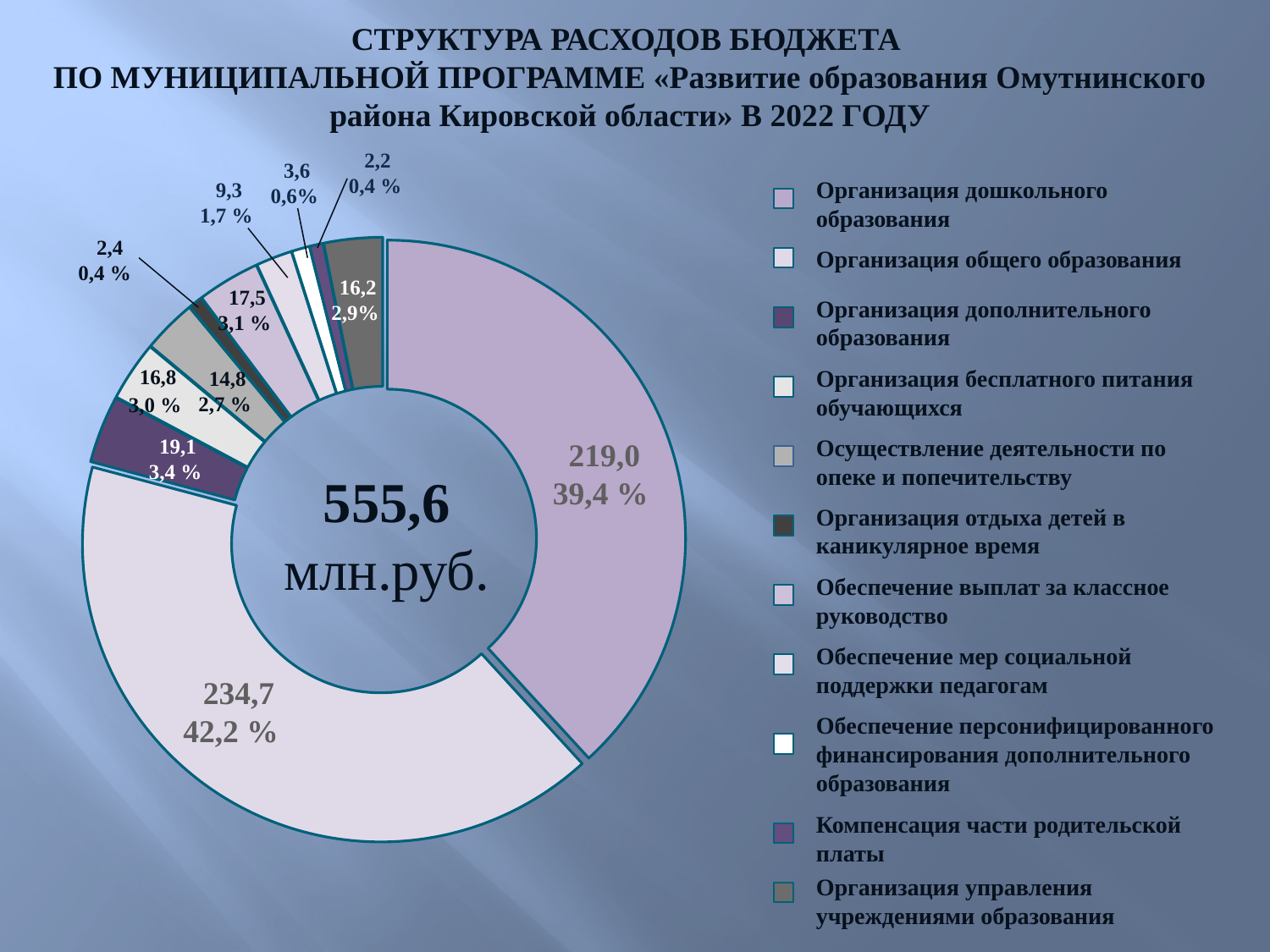
How many categories does the legend list? 11 What is the value for «Организация общего образования»? 234,7 What is the value for «Организация дошкольного образования»? 219,0 What is the value for «Организация дополнительного образования»? 19,1 What share of the chart does «Организация общего образования» take? 42,2 % Which is larger: the value for «Организация дошкольного образования» or for «Организация дополнительного образования»? Организация дошкольного образования What is the difference between the values for «Организация общего образования» and «Организация дошкольного образования»? 15,7 Which category has the largest slice in the chart? Организация общего образования What is the smallest value printed on any slice of the chart? 2,2 What total value is printed in the centre of the chart? 555,6 млн.руб. What kind of chart is shown on the slide? Pie (doughnut) chart What share of the chart does «Организация дошкольного образования» take? 39,4 %